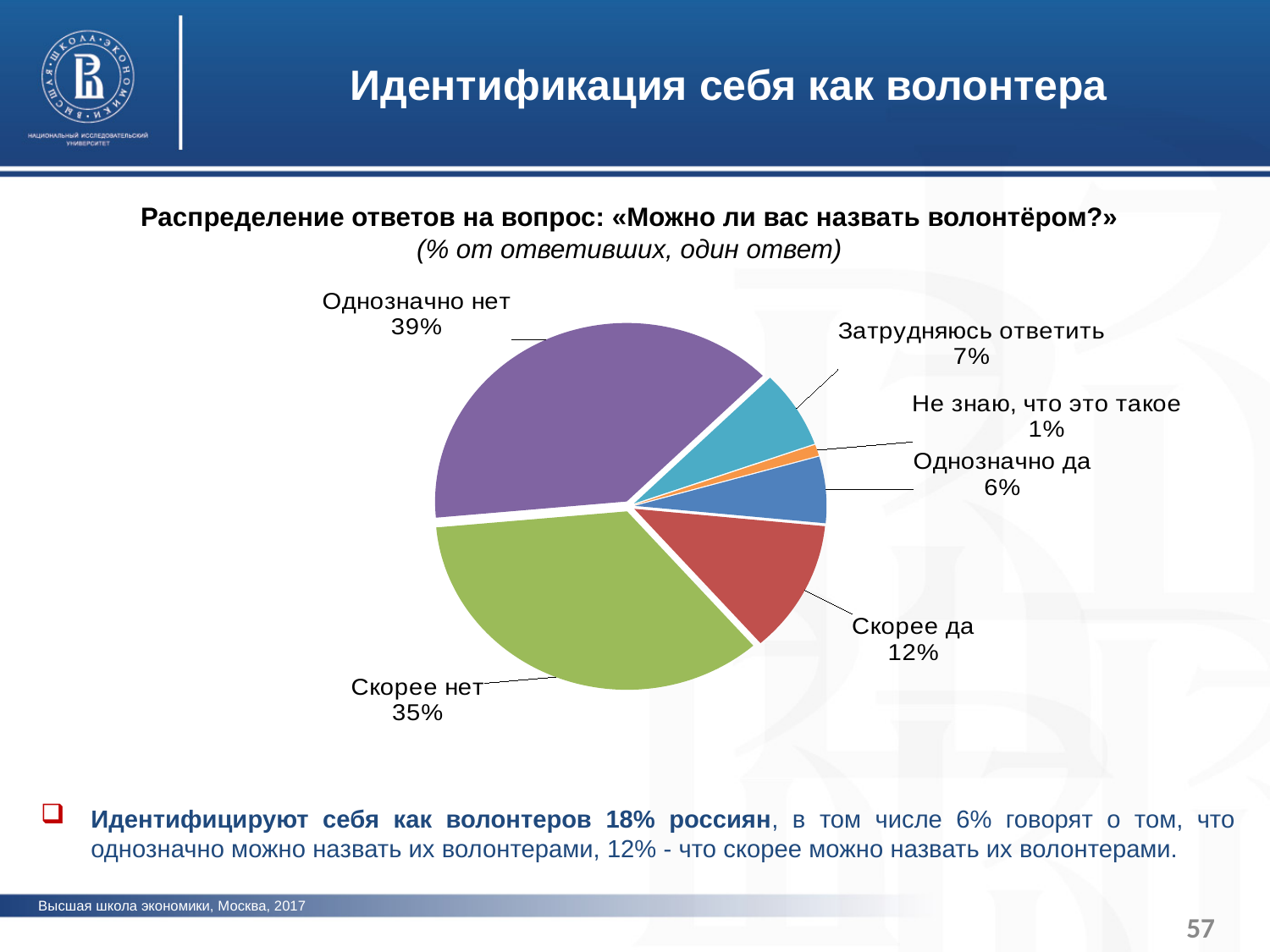
What colour is the slice for «Скорее нет»? green What percentage of respondents answered «Не знаю, что это такое»? 1% Which answer option has the smallest share of the pie? Не знаю, что это такое How many answer categories are shown in the pie chart? 6 Which answer option has the largest share of the pie? Однозначно нет Which is larger: the share for «Скорее да» or the share for «Однозначно да»? Скорее да What percentage of respondents answered «Затрудняюсь ответить»? 7% What is the difference in percentage points between «Однозначно нет» and «Скорее нет»? 4 What percentage of respondents answered «Однозначно нет»? 39% What percentage of respondents answered «Скорее да»? 12% What type of chart is shown on the slide? pie chart What is the combined share of «Однозначно да» and «Скорее да»? 18%